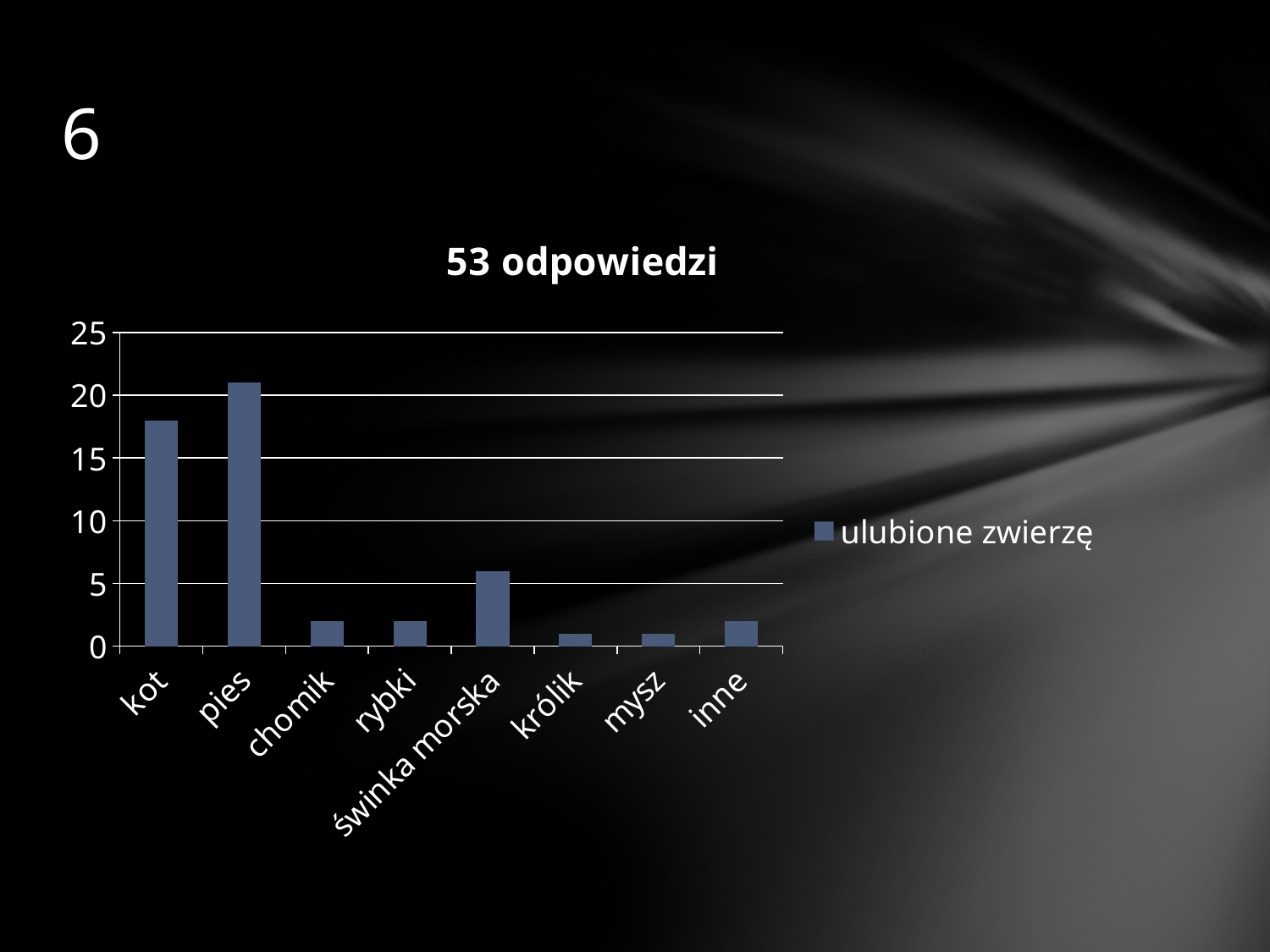
What kind of chart is shown on the slide? bar chart Is the value for kot greater or less than 15? greater How many series does the legend list? 1 Is the value for chomik greater or less than 5? less What is the title of the chart? 53 odpowiedzi What is the name of the series shown in the legend? ulubione zwierzę Is the value for świnka morska greater or less than 10? less Which is larger, the value for kot or the value for pies? pies How many categories are shown on the x axis? 8 Which category has the highest value? pies Which is larger, the value for świnka morska or the value for rybki? świnka morska